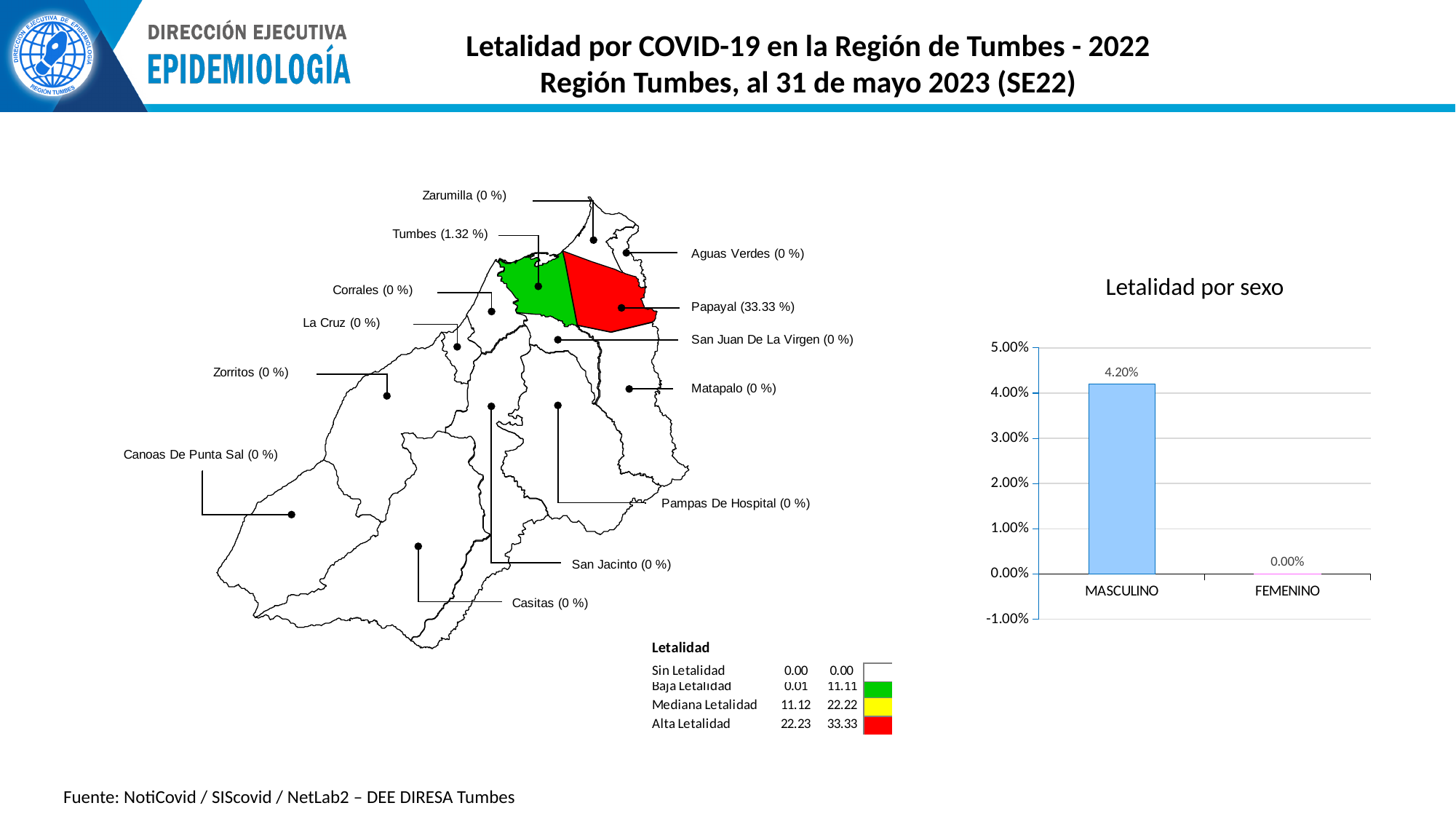
On the map, what is the lethality value shown for Tumbes? 1.32 % What kind of chart is 'Letalidad por sexo'? bar chart On the map, what is the lethality value shown for Papayal? 33.33 % In the 'Letalidad por sexo' chart, what is the difference between the MASCULINO and FEMENINO values? 4.20% In the 'Letalidad por sexo' chart, which category has the lowest value? FEMENINO How many categories are shown in the 'Letalidad por sexo' chart? 2 In the 'Letalidad por sexo' chart, which category has the highest value? MASCULINO What is the title of the chart on the right side of the slide? Letalidad por sexo In the 'Letalidad por sexo' chart, is the value for MASCULINO greater or less than 4.00%? greater In the 'Letalidad por sexo' chart, what is the value for MASCULINO? 4.20% On the map, which district has the highest lethality value? Papayal In the 'Letalidad por sexo' chart, what is the value for FEMENINO? 0.00%